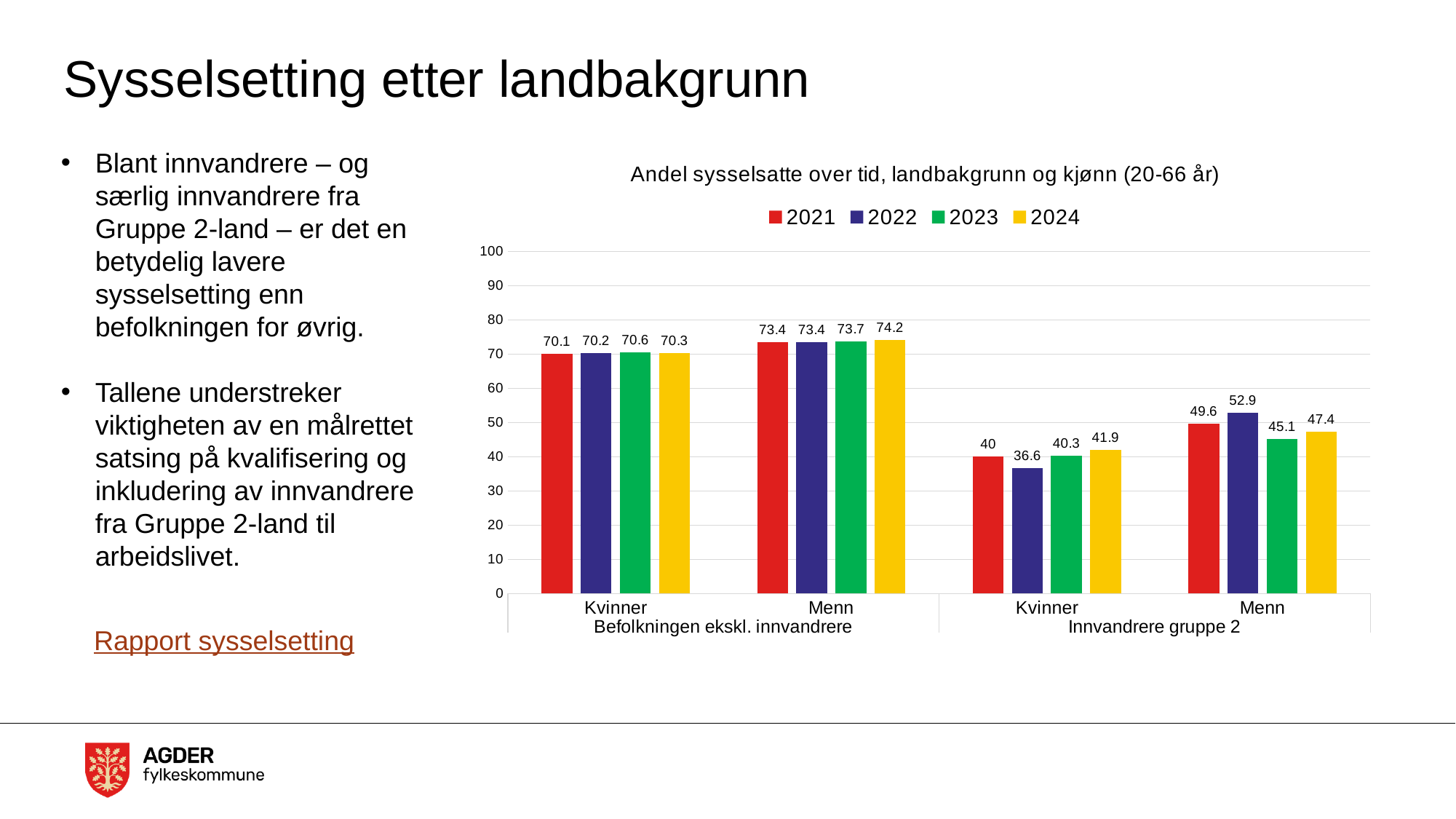
How many series does the legend list? 4 What is the value for Kvinner in Innvandrere gruppe 2 for 2024? 41.9 Which year has the highest value for Menn in Befolkningen ekskl. innvandrere? 2024 What is the difference between the 2024 values for Menn in Befolkningen ekskl. innvandrere and Menn in Innvandrere gruppe 2? 26.8 What is the title of the chart? Andel sysselsatte over tid, landbakgrunn og kjønn (20-66 år) Which is larger for Menn in Innvandrere gruppe 2: the 2023 value or the 2024 value? 2024 Which year has the lowest value for Kvinner in Innvandrere gruppe 2? 2022 Do the values for Menn in Befolkningen ekskl. innvandrere rise or fall from 2021 to 2024? Rise Is the 2022 value for Kvinner in Innvandrere gruppe 2 greater or less than 40? less What kind of chart is shown on the slide? Bar chart What is the value for Menn in Innvandrere gruppe 2 for 2022? 52.9 What is the value for Kvinner in Befolkningen ekskl. innvandrere for 2021? 70.1